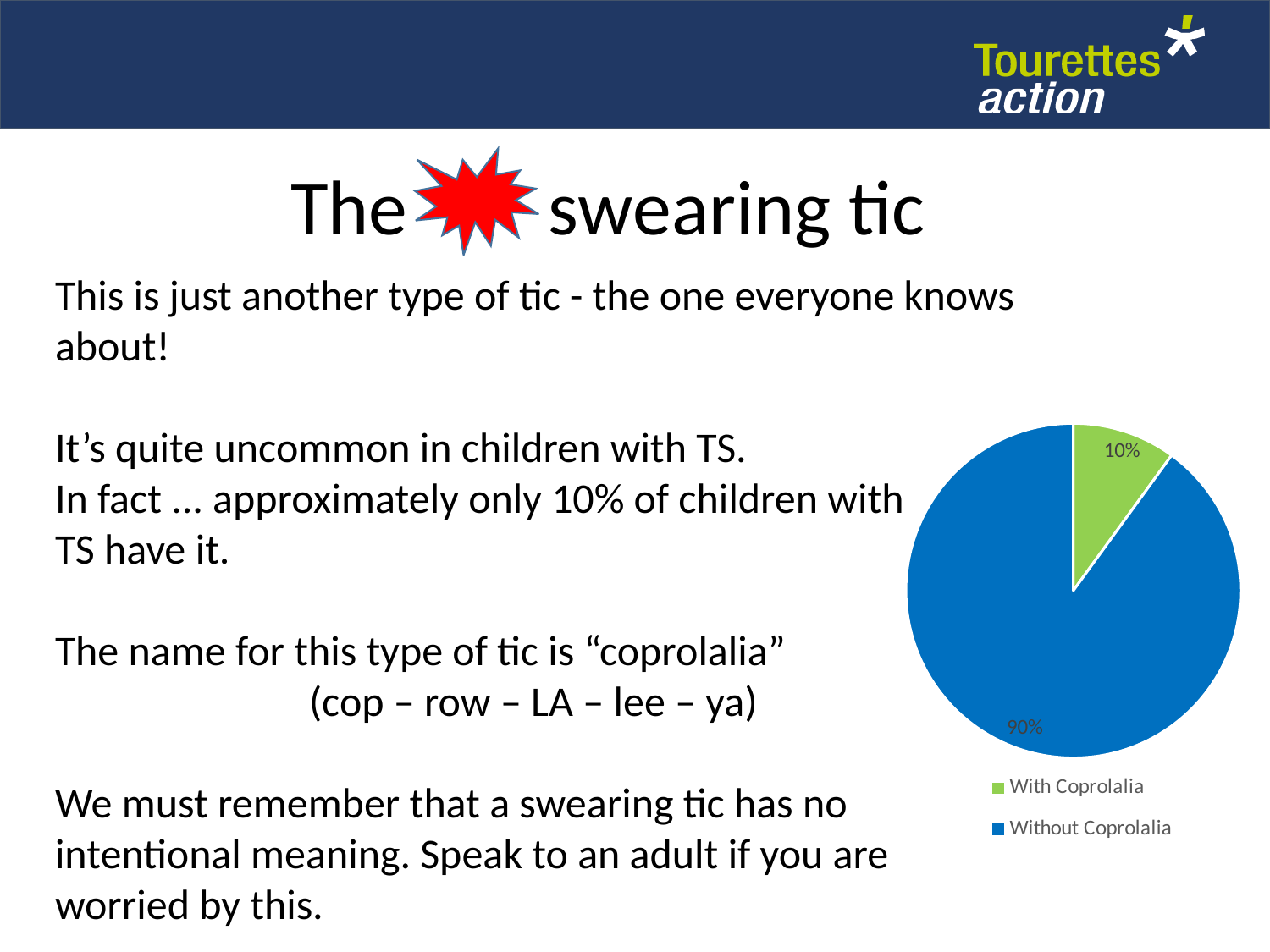
What share of the pie does the With Coprolalia slice represent? 10% How many slices does the pie chart have? 2 Which is larger, the With Coprolalia slice or the Without Coprolalia slice? Without Coprolalia What kind of chart is shown on the slide? pie chart What percentage of the pie is labelled for With Coprolalia? 10% Which slice of the pie is the smallest? With Coprolalia What is the difference in percentage points between the Without Coprolalia slice and the With Coprolalia slice? 80 How many entries does the legend list? 2 What colour is the With Coprolalia slice in the pie chart? green Which slice of the pie is the largest? Without Coprolalia What colour is the Without Coprolalia slice in the pie chart? blue What percentage of the pie is labelled for Without Coprolalia? 90%